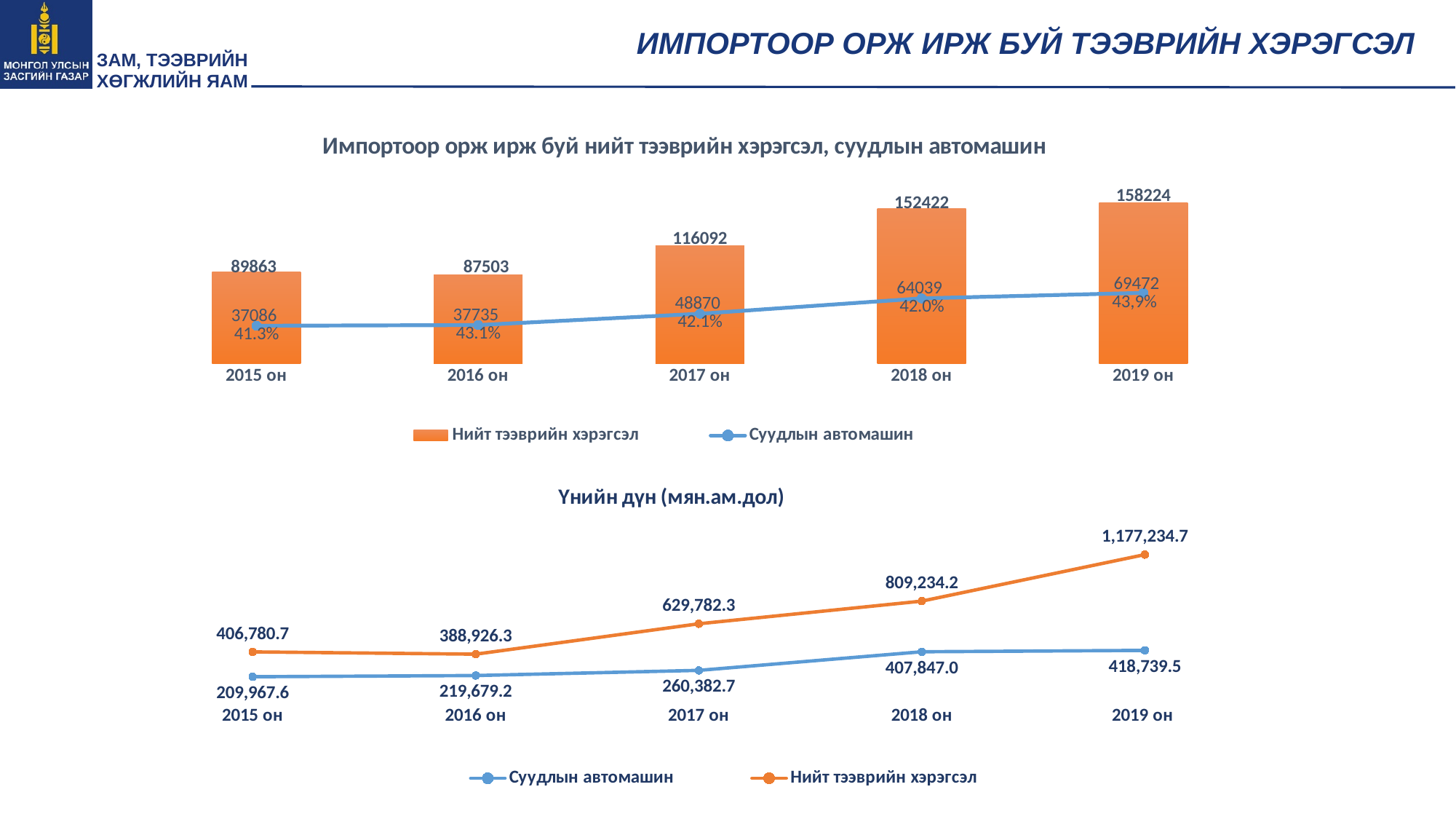
In the bottom chart (Үнийн дүн), what is the value of Суудлын автомашин for 2015 он? 209,967.6 How many series does the legend of the bottom chart (Үнийн дүн) list? 2 In the bottom chart (Үнийн дүн), which is larger: Суудлын автомашин in 2018 он or in 2017 он? 2018 он In the top chart, what is the difference between Нийт тээврийн хэрэгсэл in 2019 он and 2018 он? 5802 In the top chart, which year has the highest value for Нийт тээврийн хэрэгсэл? 2019 он In the bottom chart (Үнийн дүн), which year has the lowest value for Нийт тээврийн хэрэгсэл? 2016 он In the top chart, which year has the lowest value for Нийт тээврийн хэрэгсэл? 2016 он In the bottom chart (Үнийн дүн), what is the value of Нийт тээврийн хэрэгсэл for 2019 он? 1,177,234.7 In the top chart, what is the value of Нийт тээврийн хэрэгсэл for 2018 он? 152422 In the top chart, what is the value of Суудлын автомашин for 2017 он? 48870 In the top chart, how many years are shown on the x axis? 5 In the top chart, what percentage is shown for Суудлын автомашин in 2019 он? 43,9%